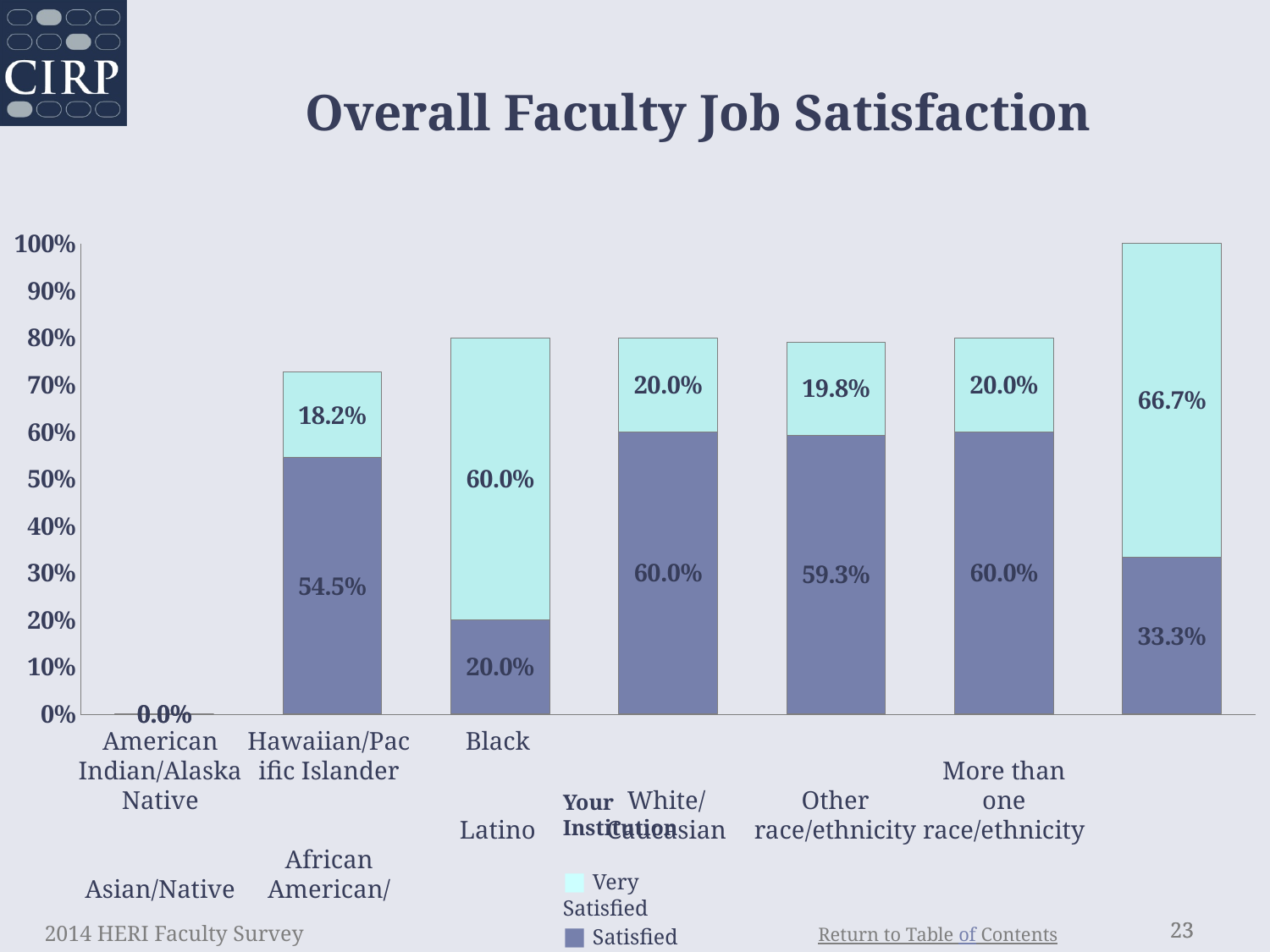
What is the Satisfied value for White/Caucasian faculty? 59.3% What is the Satisfied value for Latino faculty? 60.0% How many series does the legend list? 2 Is the total bar height for Asian/Native Hawaiian/Pacific Islander greater or less than 80%? less For faculty of more than one race/ethnicity, how much larger is the Very Satisfied value than the Satisfied value? 33.4% Which has a larger Satisfied value: Asian/Native Hawaiian/Pacific Islander or Latino? Latino What is the Very Satisfied value for faculty of more than one race/ethnicity? 66.7% What is the combined Satisfied and Very Satisfied total for White/Caucasian faculty? 79.1% Which category has the lowest overall bar? American Indian/Alaska Native What kind of chart is shown on the slide? Stacked bar chart How many race/ethnicity categories are shown on the x axis? 7 Which category has the highest Very Satisfied value? More than one race/ethnicity